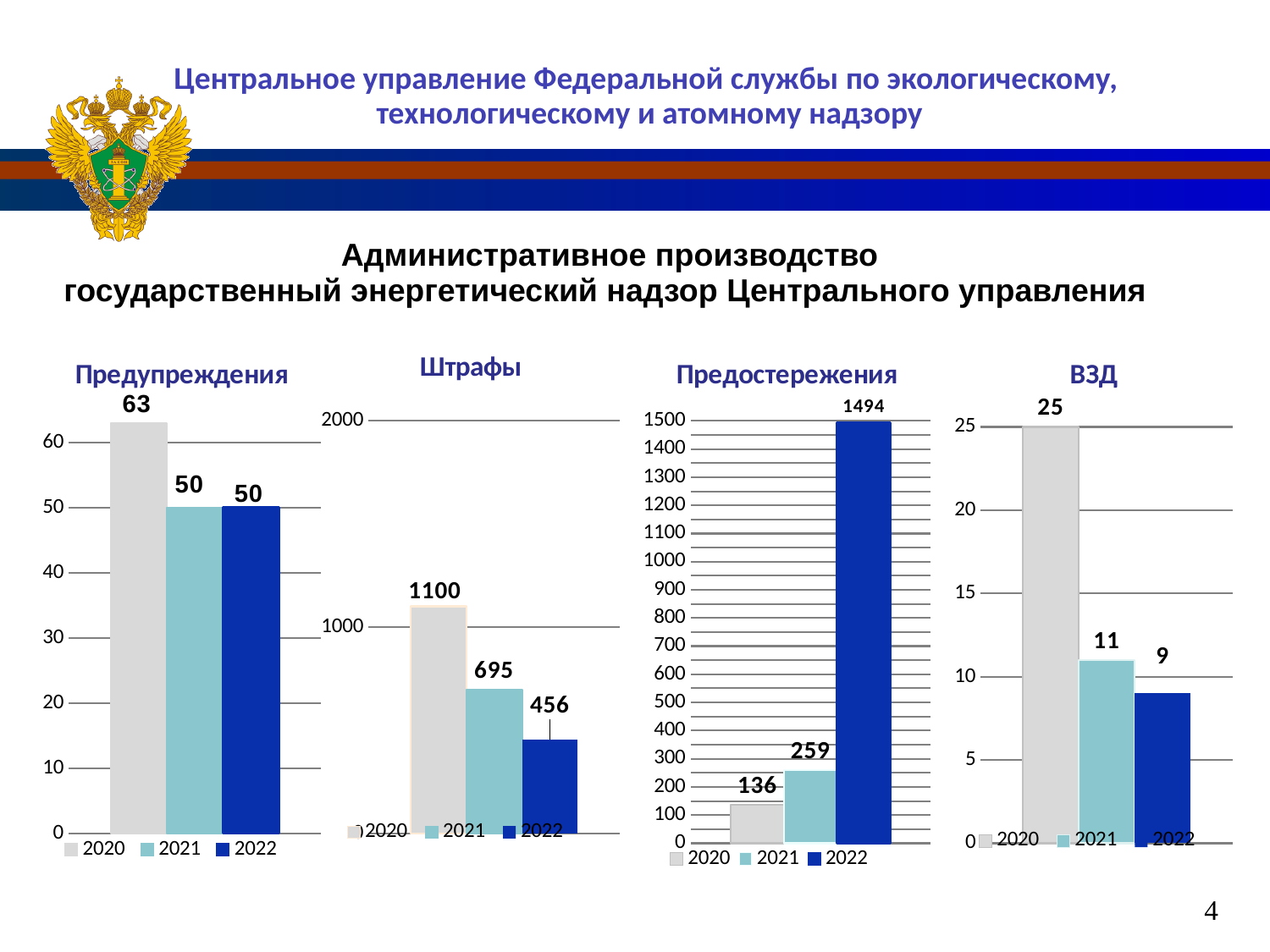
In the "Предостережения" chart, what is the value for 2021? 259 In the "ВЗД" chart, which is larger: the value for 2021 or the value for 2022? 2021 In the "Предостережения" chart, is the value for 2022 greater or less than 1000? greater In the "ВЗД" chart, what is the value for 2020? 25 In the "Штрафы" chart, what is the value for 2022? 456 In the "Штрафы" chart, what is the difference between the 2020 and 2021 values? 405 In the "Штрафы" chart, which year has the lowest value? 2022 How many bars are plotted in the "Предупреждения" chart? 3 What kind of chart is the "Штрафы" chart? bar chart In the "ВЗД" chart, do the values rise or fall from 2020 to 2022? fall In the "Предостережения" chart, which year has the highest value? 2022 In the "Предупреждения" chart, what is the value for 2020? 63